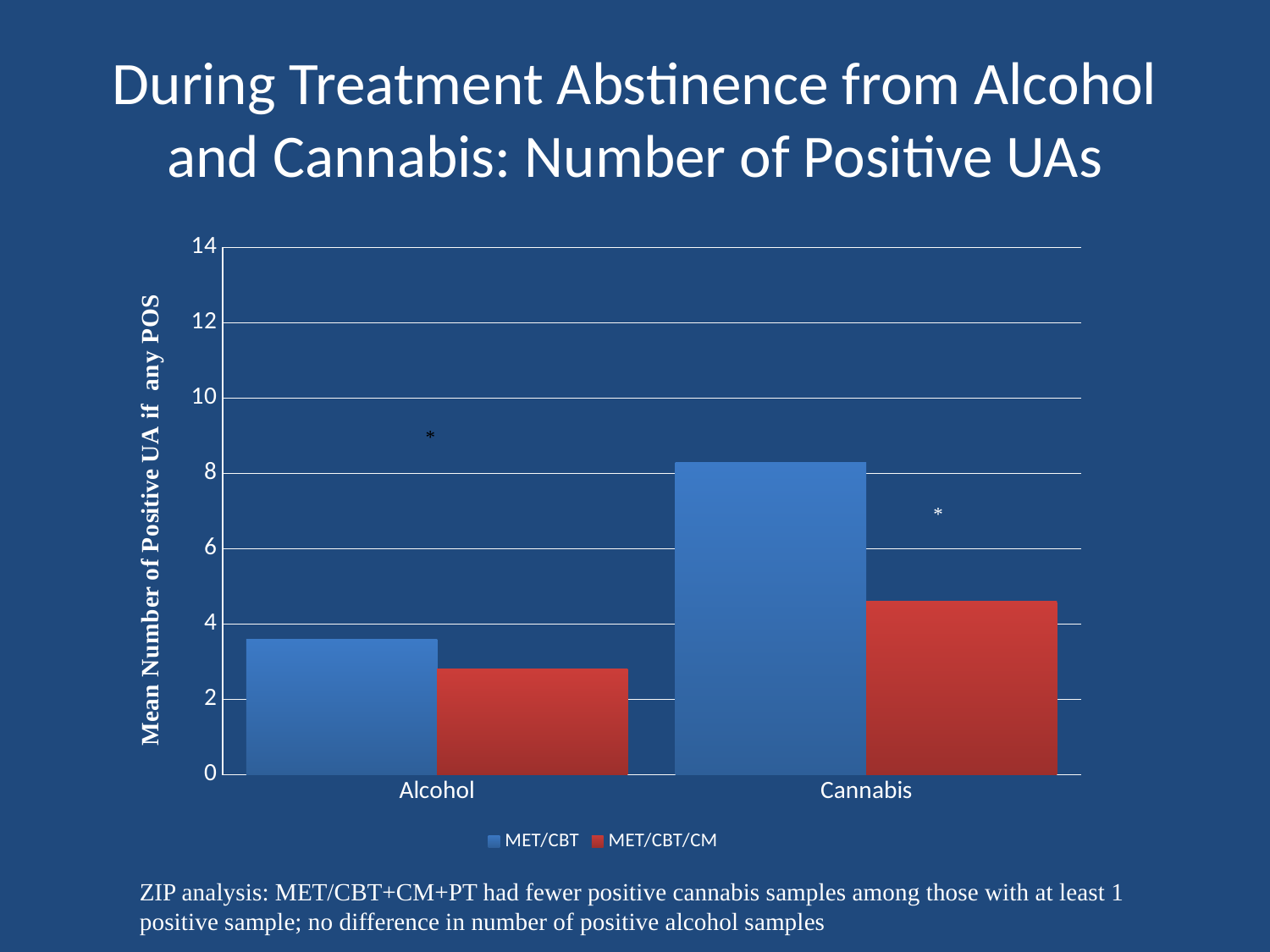
Is the value for MET/CBT in the Alcohol category greater or less than 4? less For Alcohol, which series has the larger value, MET/CBT or MET/CBT/CM? MET/CBT How many categories are shown on the x axis? 2 Which category has the highest bar for MET/CBT? Cannabis What kind of chart is shown on the slide? bar chart Is the value for MET/CBT in the Cannabis category greater or less than 8? greater How many series does the legend list? 2 What is the label of the y axis? Mean Number of Positive UA if any POS Which category has the lowest bar for MET/CBT/CM? Alcohol For Cannabis, which series has the larger value, MET/CBT or MET/CBT/CM? MET/CBT Is the value for MET/CBT/CM in the Alcohol category greater or less than 2? greater